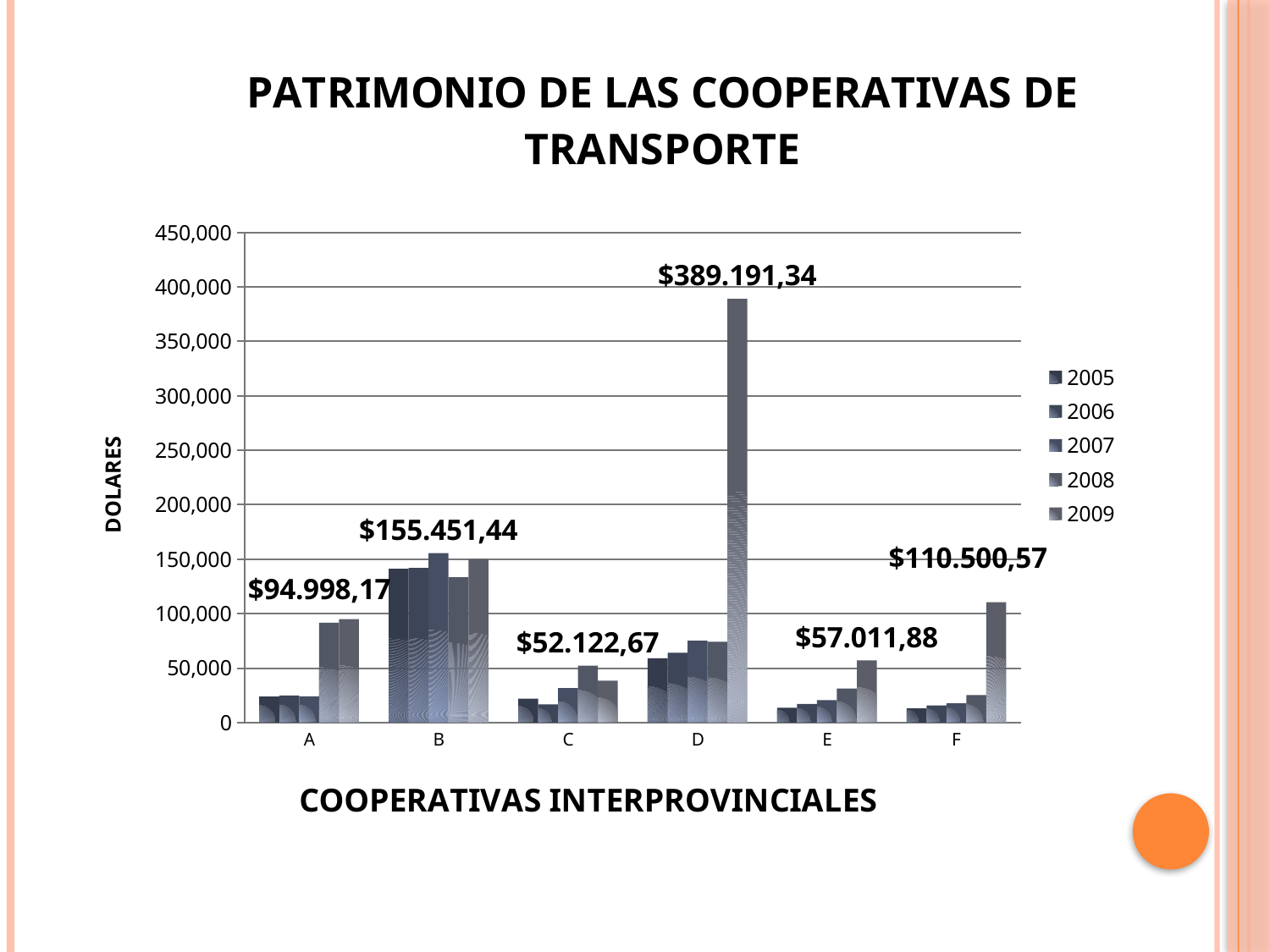
Which labelled value is larger, the one for cooperativa E or the one for cooperativa C? E What kind of chart is shown on the slide? bar chart Which cooperativa has the lowest labelled value? C What is the labelled value shown above cooperativa A? $94.998,17 What is the title of the vertical axis? DOLARES How many cooperativas (categories) are shown on the x axis? 6 How many series does the legend list? 5 What is the labelled value shown above cooperativa D? $389.191,34 What is the labelled value shown above cooperativa F? $110.500,57 Is the 2005 value for cooperativa A greater or less than 50,000? less Which cooperativa has the tallest bar in the chart? D What is the difference between the labelled values for cooperativa D and cooperativa C? $337.068,67